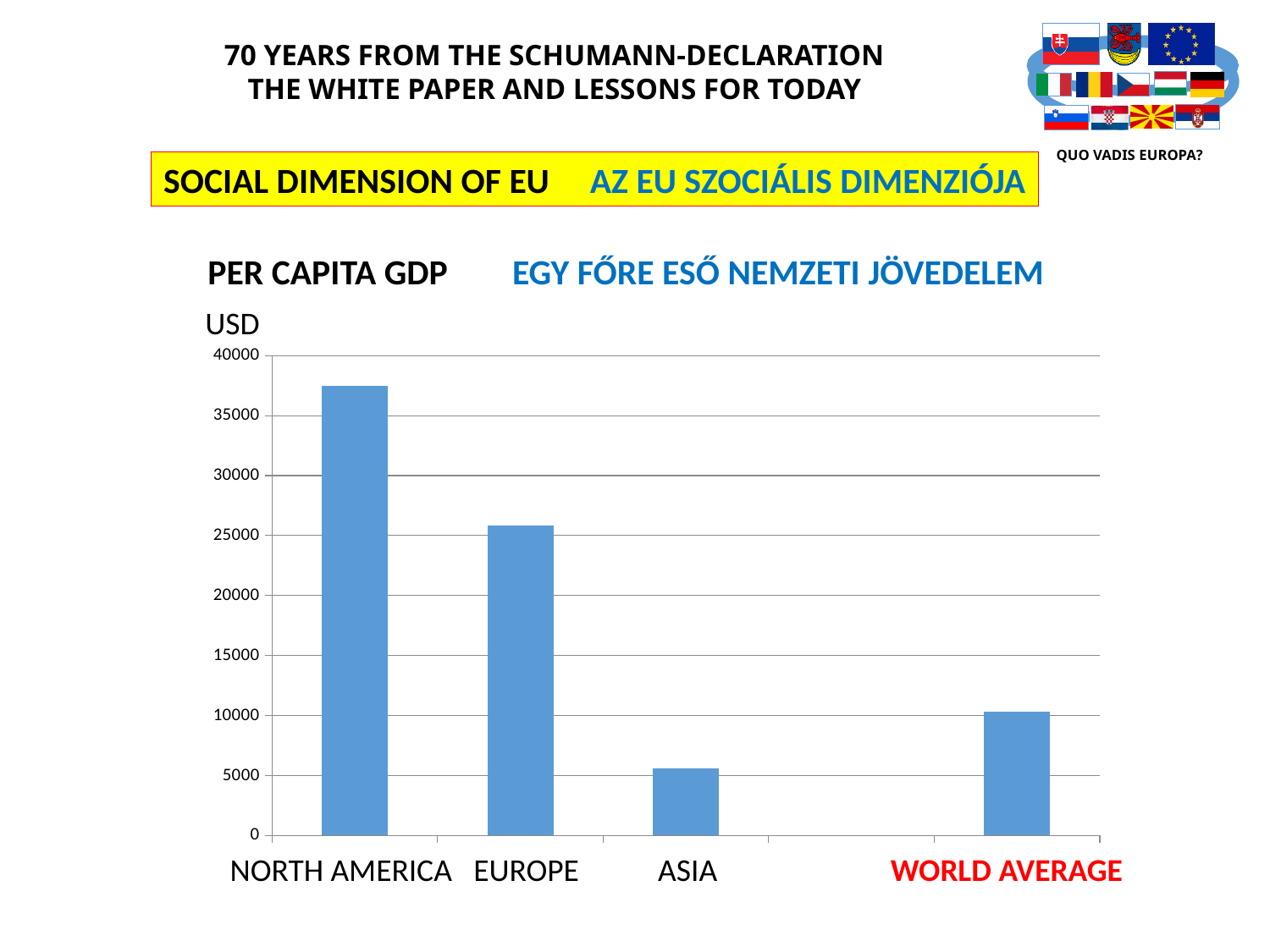
Which is larger, the value for ASIA or the value for WORLD AVERAGE? WORLD AVERAGE Is the value for NORTH AMERICA greater or less than 35000? greater Which category has the highest per capita GDP in the chart? NORTH AMERICA What unit is shown above the vertical axis of the chart? USD Is the value for EUROPE greater or less than 30000? less Which is larger, the value for EUROPE or the value for WORLD AVERAGE? EUROPE What kind of chart is shown on the slide? bar chart Which category has the lowest per capita GDP in the chart? ASIA How many labelled categories are shown on the x axis of the chart? 4 Is the value for ASIA greater or less than 10000? less